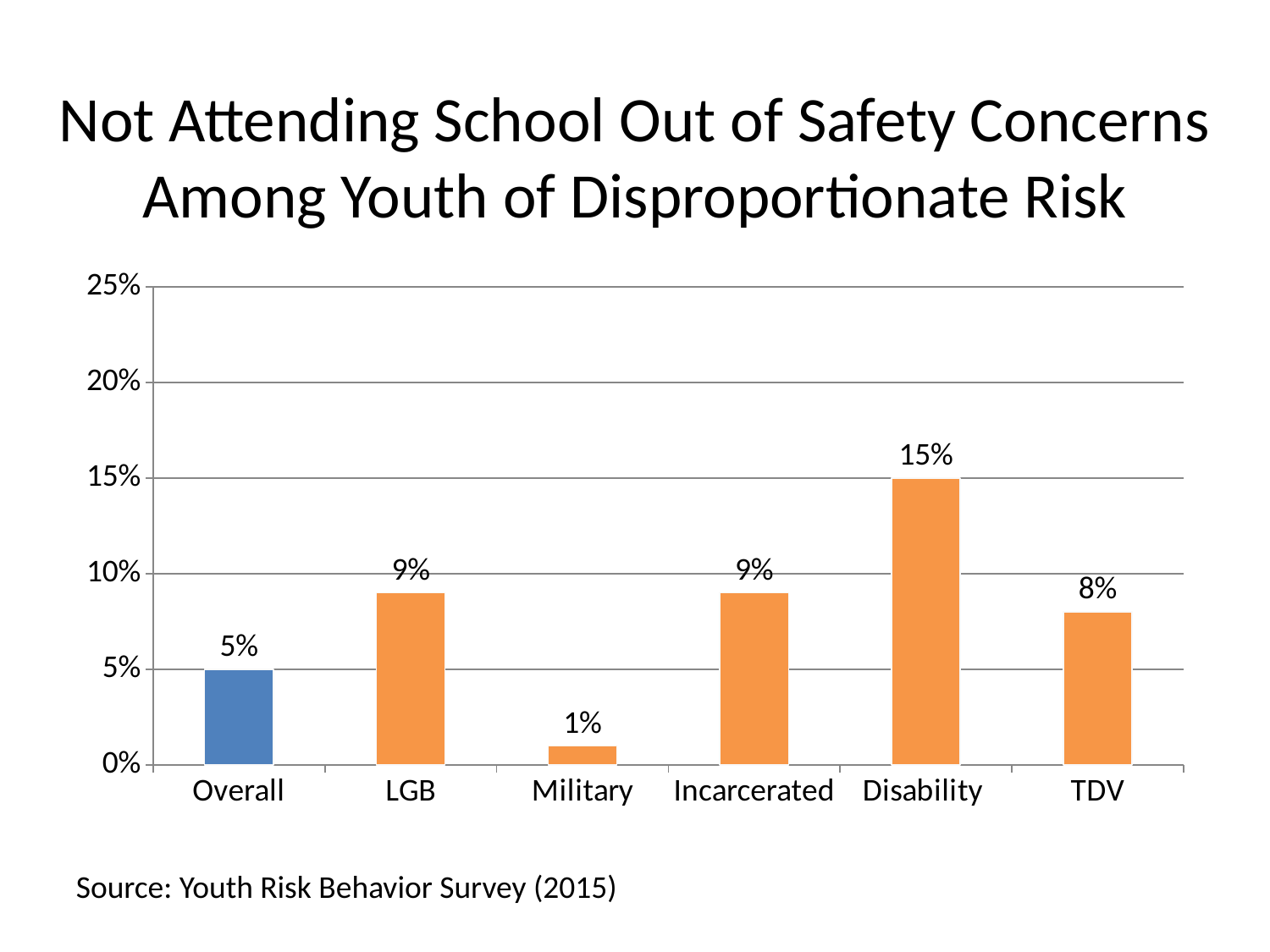
What is the value for Overall? 5% Which category has the highest value? Disability Which category has the lowest value? Military Which is larger, the value for Incarcerated or the value for TDV? Incarcerated What kind of chart is shown on the slide? Bar chart Which category's bar is shown in blue rather than orange? Overall What is the difference between the values for LGB and TDV? 1% What is the value for TDV? 8% What is the value for Military? 1% What is the value for Disability? 15% How many categories are shown on the x axis? 6 What is the difference between the values for Disability and Overall? 10%